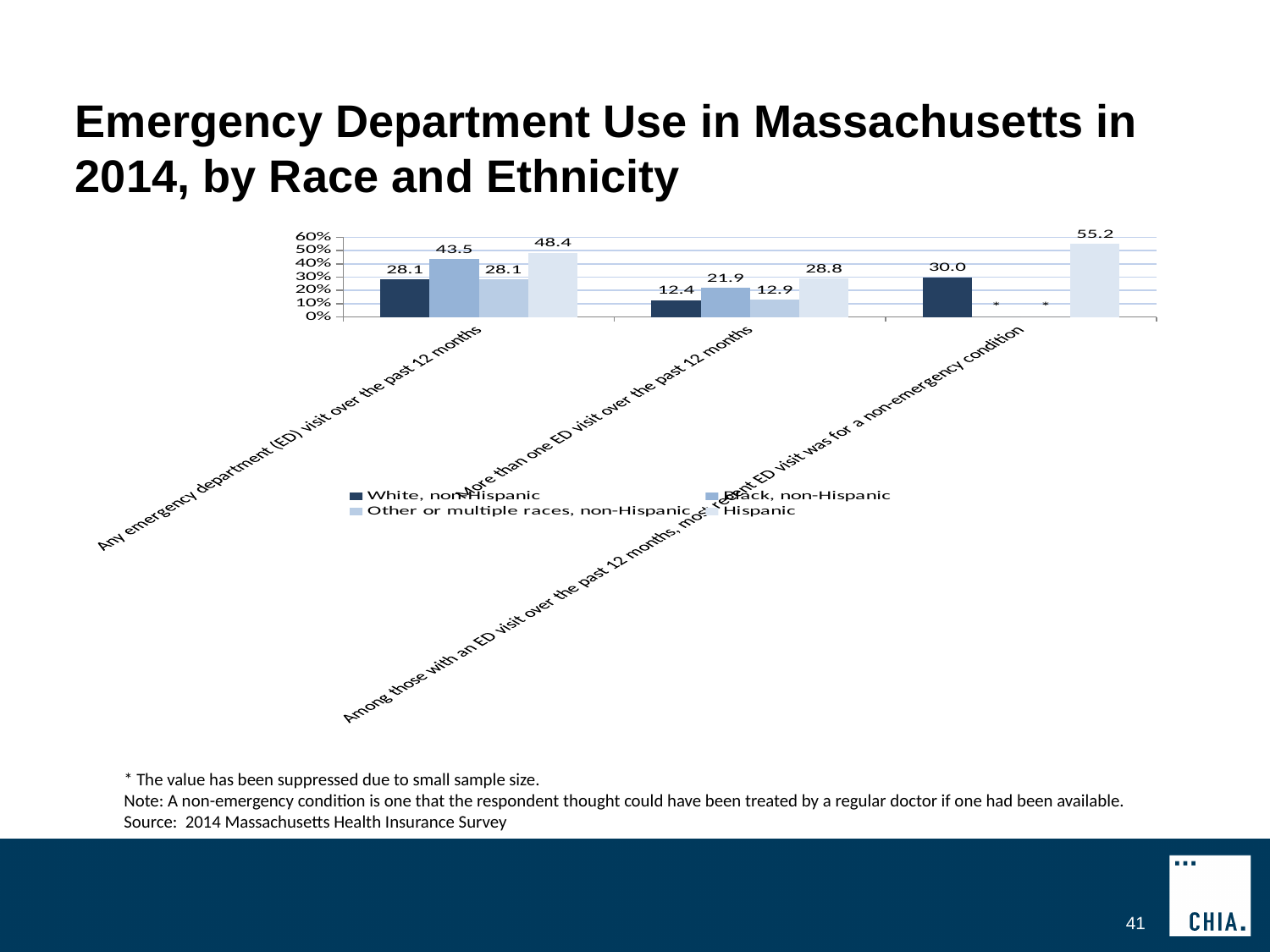
How many series does the legend list? 4 What is the value for Hispanic respondents for 'Any emergency department (ED) visit over the past 12 months'? 48.4 Is the Hispanic value for the non-emergency condition category greater or less than 50%? greater Which groups have suppressed values (marked with *) in the non-emergency condition category? Black, non-Hispanic and Other or multiple races, non-Hispanic What is the value for White, non-Hispanic respondents for the category where the most recent ED visit was for a non-emergency condition? 30.0 How many categories are shown on the x axis? 3 What is the difference between the Hispanic and White, non-Hispanic values for the non-emergency condition category? 25.2 Which group has the lowest value for 'More than one ED visit over the past 12 months'? White, non-Hispanic Which group has the highest value for 'Any emergency department (ED) visit over the past 12 months'? Hispanic What type of chart is shown on the slide? Bar chart For 'Any emergency department (ED) visit over the past 12 months', which is larger: the value for Black, non-Hispanic or for Other or multiple races, non-Hispanic? Black, non-Hispanic What is the value for Black, non-Hispanic respondents for 'More than one ED visit over the past 12 months'? 21.9